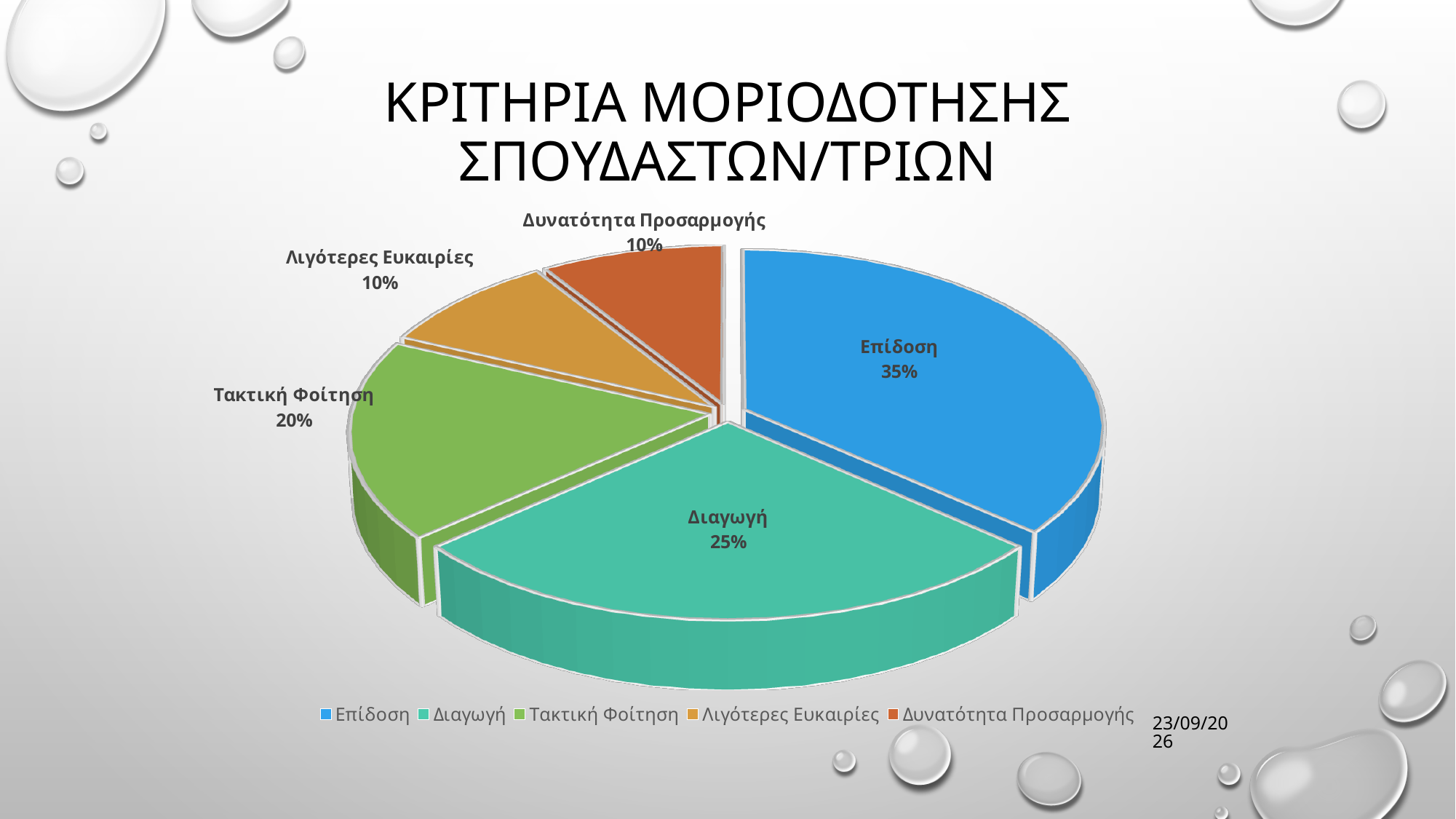
What share of the pie does Επίδοση have? 35% What share of the pie does Δυνατότητα Προσαρμογής have? 10% Which is larger, the share for Τακτική Φοίτηση or the share for Διαγωγή? Διαγωγή What share of the pie does Λιγότερες Ευκαιρίες have? 10% What is the difference in percentage points between Επίδοση and Διαγωγή? 10 Which category has the largest slice of the pie? Επίδοση What kind of chart is shown on the slide? Pie chart What is the combined share of Λιγότερες Ευκαιρίες and Δυνατότητα Προσαρμογής? 20% How many slices does the pie chart have? 5 What is the title of the chart slide? ΚΡΙΤΗΡΙΑ ΜΟΡΙΟΔΟΤΗΣΗΣ ΣΠΟΥΔΑΣΤΩΝ/ΤΡΙΩΝ